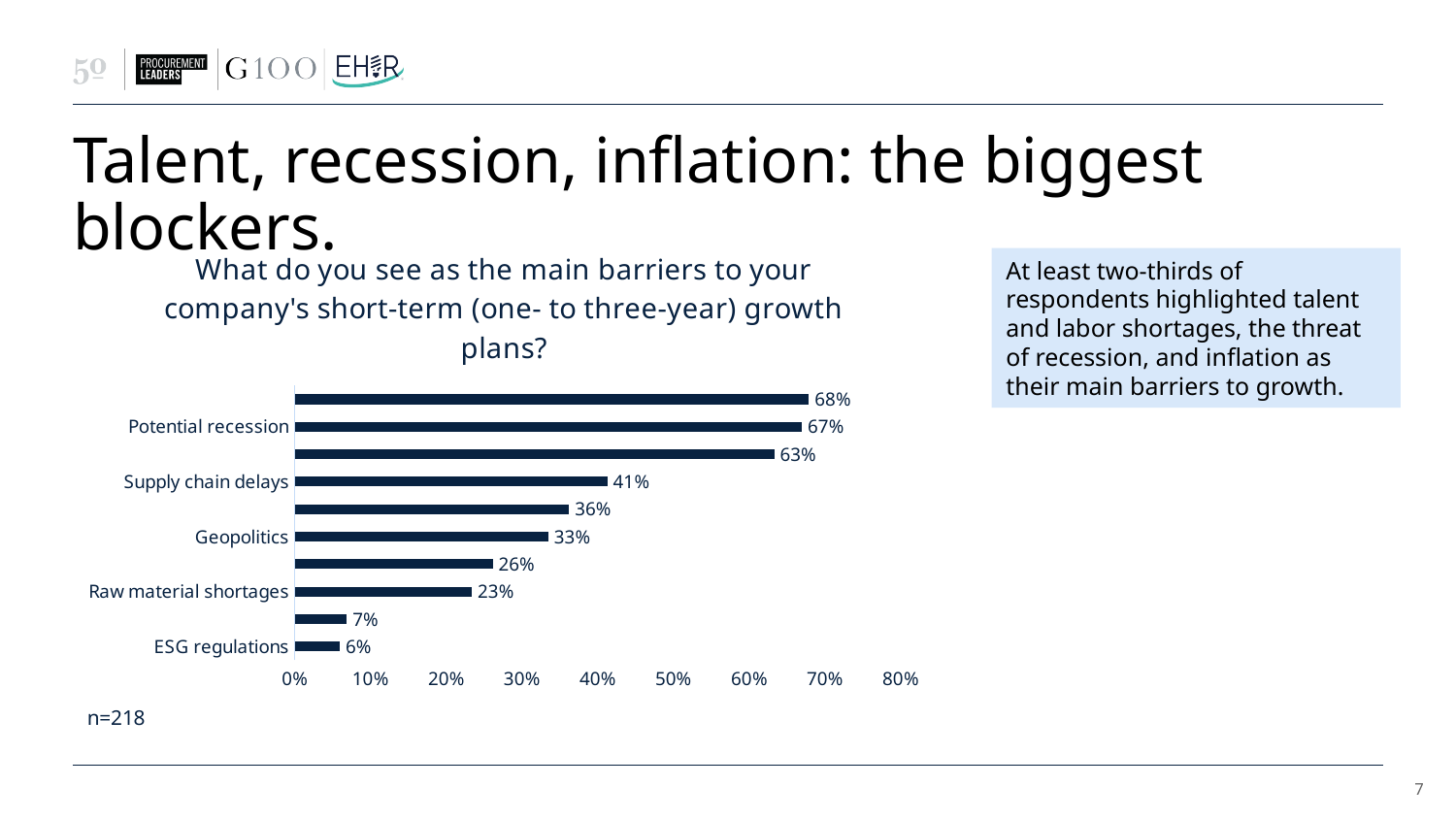
What is the value shown for Raw material shortages? 23% How many percentage points higher is Potential recession than Supply chain delays? 26 percentage points What is the value shown for Geopolitics? 33% Which labeled category has the lowest value in the chart? ESG regulations What is the value shown for ESG regulations? 6% What is the highest value shown on any bar in the chart? 68% What percentage of respondents cited Potential recession as a barrier to short-term growth? 67% How many bars are plotted in the chart? 10 What type of chart is shown on the slide? Bar chart Which has a larger value, Supply chain delays or Geopolitics? Supply chain delays What is the value shown for Supply chain delays? 41% Is the value for Potential recession greater or less than 60%? greater